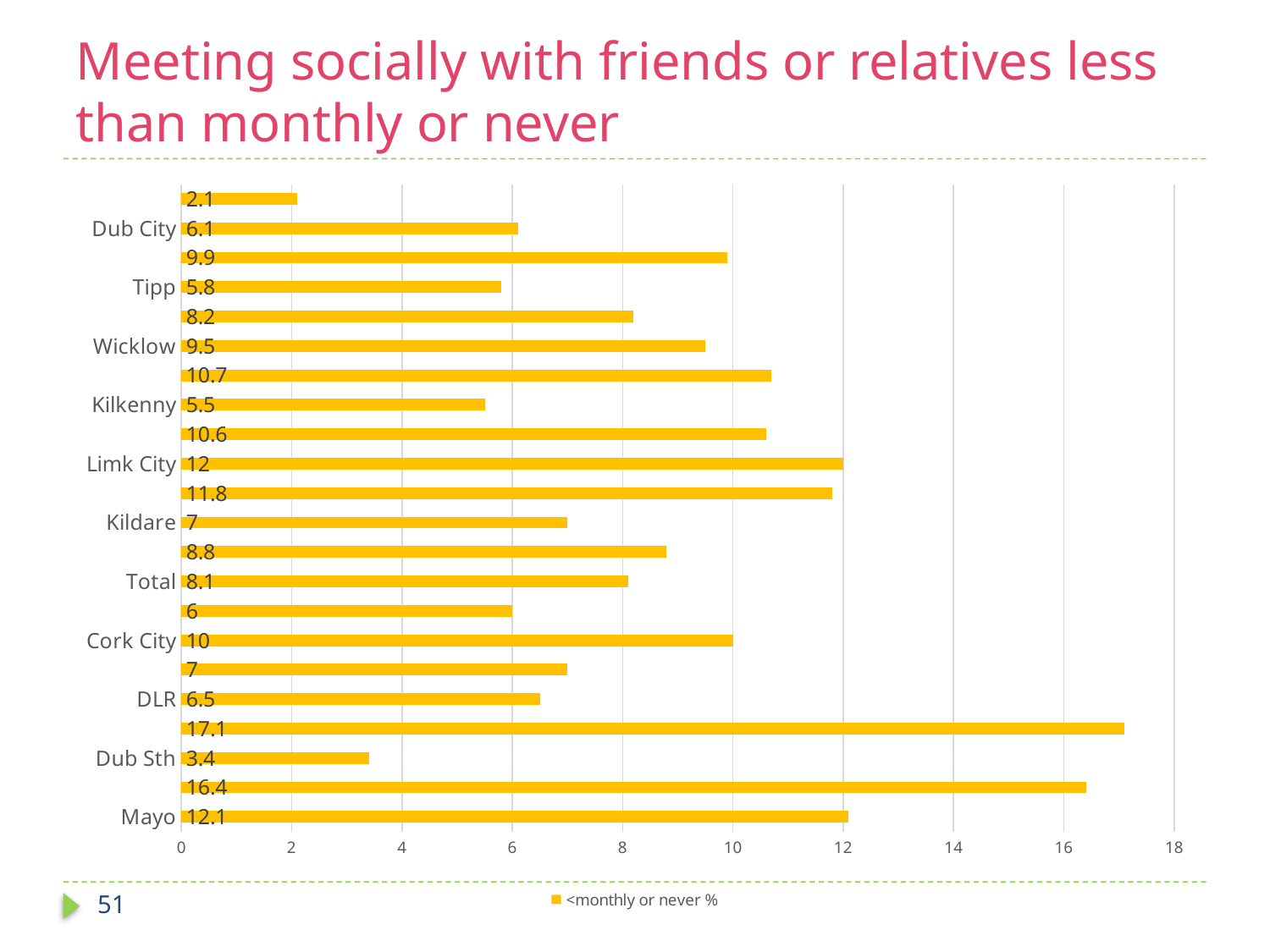
Which is larger, the value for Wicklow or the value for DLR? Wicklow What is the legend entry for the series shown? <monthly or never % Is the value for Cork City greater or less than 8? greater What is the difference between the values for Limk City and Tipp? 6.2 What is the difference between the values for Cork City and Kildare? 3 What kind of chart is shown on the slide? bar chart What is the value for Dub Sth? 3.4 What is the value for Dub City? 6.1 What is the value for Mayo? 12.1 What is the value for Total? 8.1 What is the value for Kilkenny? 5.5 How many series does the legend list? 1